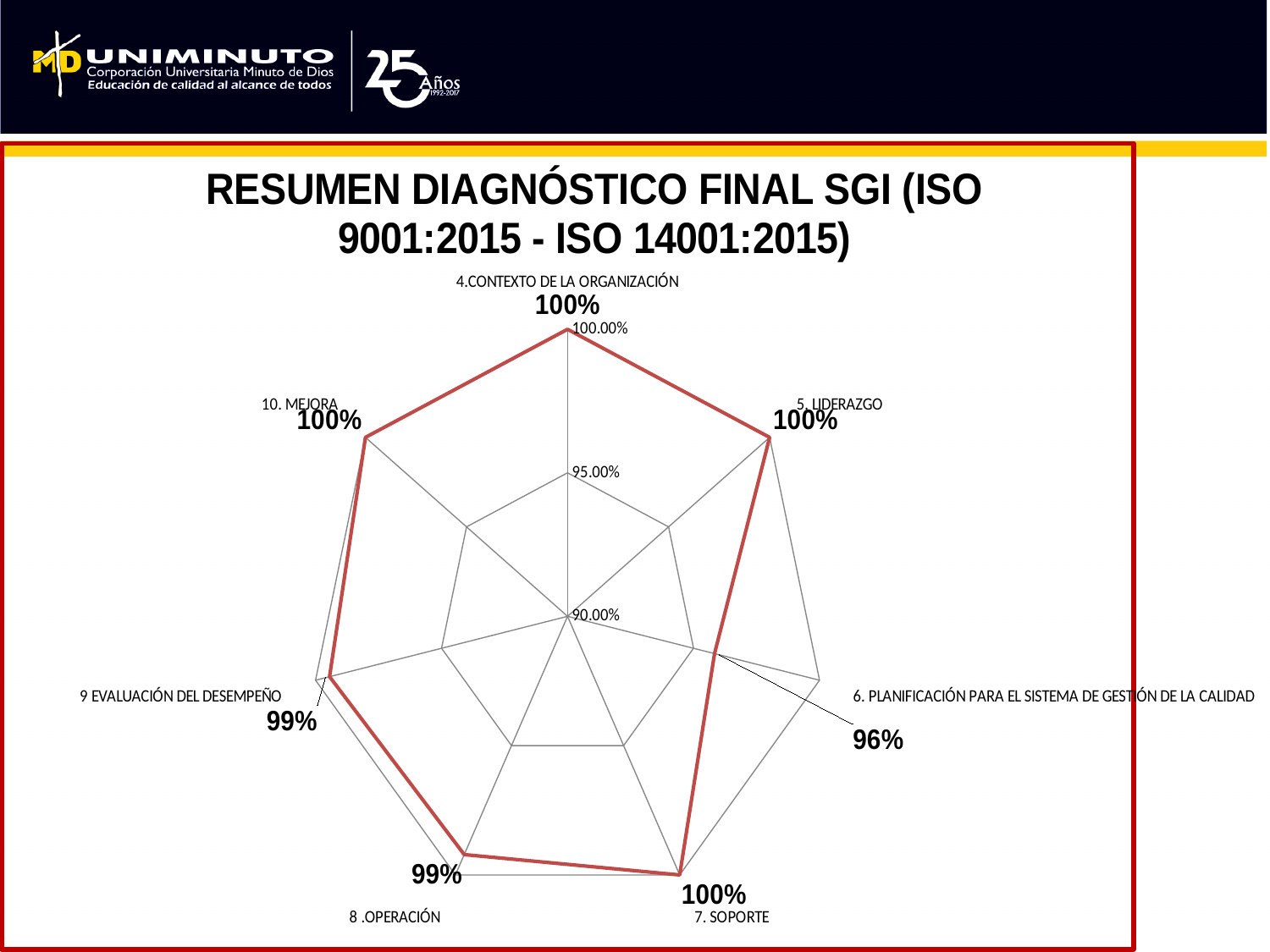
What is the value for 4.CONTEXTO DE LA ORGANIZACIÓN? 100% Is the value for 6. PLANIFICACIÓN PARA EL SISTEMA DE GESTIÓN DE LA CALIDAD greater or less than 95.00%? greater What is the title of the chart? RESUMEN DIAGNÓSTICO FINAL SGI (ISO 9001:2015 - ISO 14001:2015) How many categories are plotted on the radar chart? 7 What is the value for 9 EVALUACIÓN DEL DESEMPEÑO? 99% What is the value for 5. LIDERAZGO? 100% What type of chart is shown on the slide? Radar chart Which category has the lowest value? 6. PLANIFICACIÓN PARA EL SISTEMA DE GESTIÓN DE LA CALIDAD What is the difference between the value for 7. SOPORTE and the value for 6. PLANIFICACIÓN PARA EL SISTEMA DE GESTIÓN DE LA CALIDAD? 4% What is the value for 8 .OPERACIÓN? 99% Which is larger, the value for 10. MEJORA or the value for 8 .OPERACIÓN? 10. MEJORA What is the value for 6. PLANIFICACIÓN PARA EL SISTEMA DE GESTIÓN DE LA CALIDAD? 96%